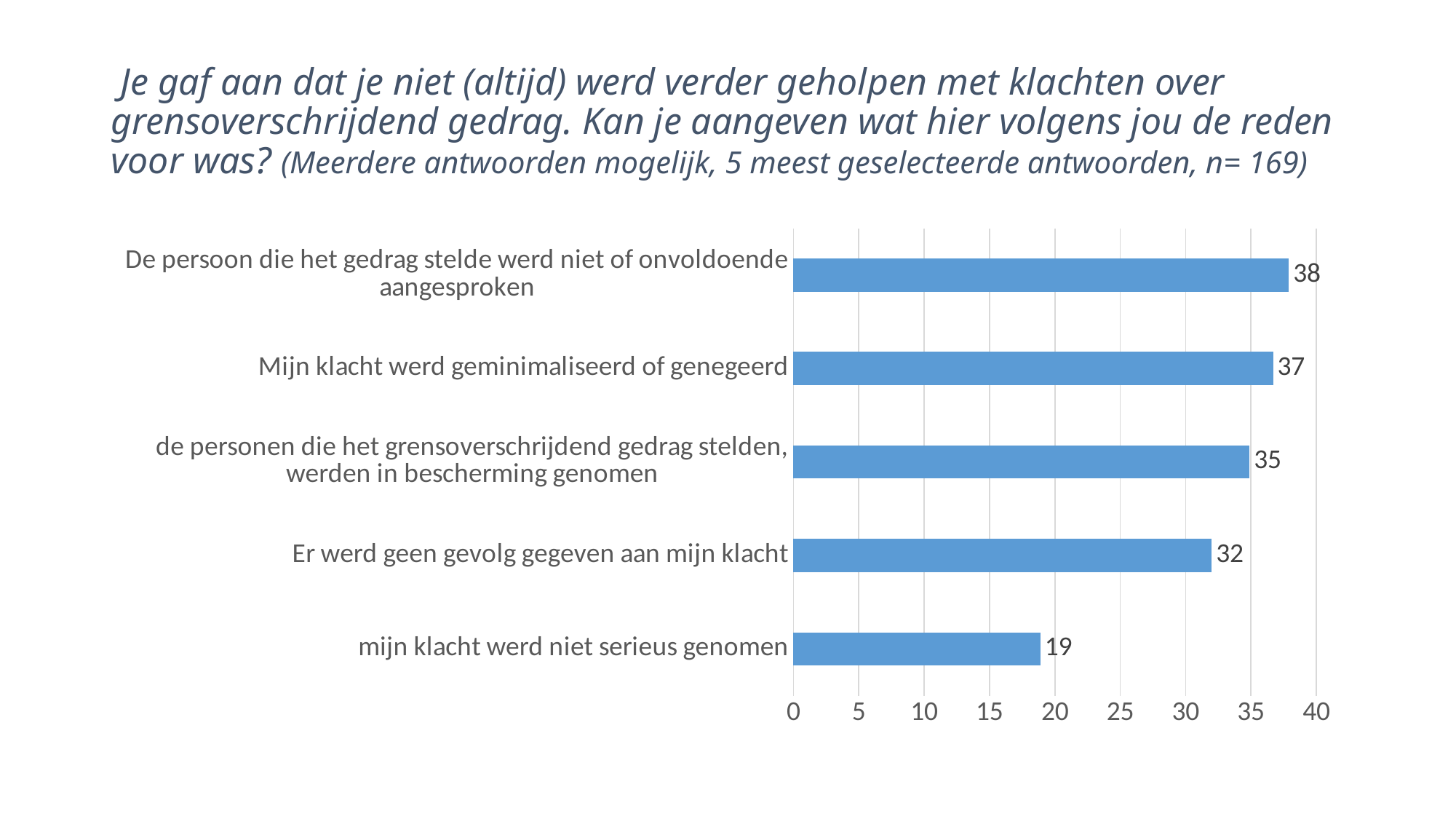
What is the value for "Er werd geen gevolg gegeven aan mijn klacht"? 32 Which category has the lowest value? mijn klacht werd niet serieus genomen What is the difference between the values for "de personen die het grensoverschrijdend gedrag stelden, werden in bescherming genomen" and "Er werd geen gevolg gegeven aan mijn klacht"? 3 What kind of chart is shown on the slide? bar chart Is the value for "mijn klacht werd niet serieus genomen" greater or less than 20? less What is the value for "mijn klacht werd niet serieus genomen"? 19 What is the difference between the values for "De persoon die het gedrag stelde werd niet of onvoldoende aangesproken" and "mijn klacht werd niet serieus genomen"? 19 Which category has the highest value? De persoon die het gedrag stelde werd niet of onvoldoende aangesproken How many categories are shown in the chart? 5 What is the maximum value shown on the horizontal axis? 40 What is the value for "Mijn klacht werd geminimaliseerd of genegeerd"? 37 Which is larger: the value for "Er werd geen gevolg gegeven aan mijn klacht" or the value for "mijn klacht werd niet serieus genomen"? Er werd geen gevolg gegeven aan mijn klacht